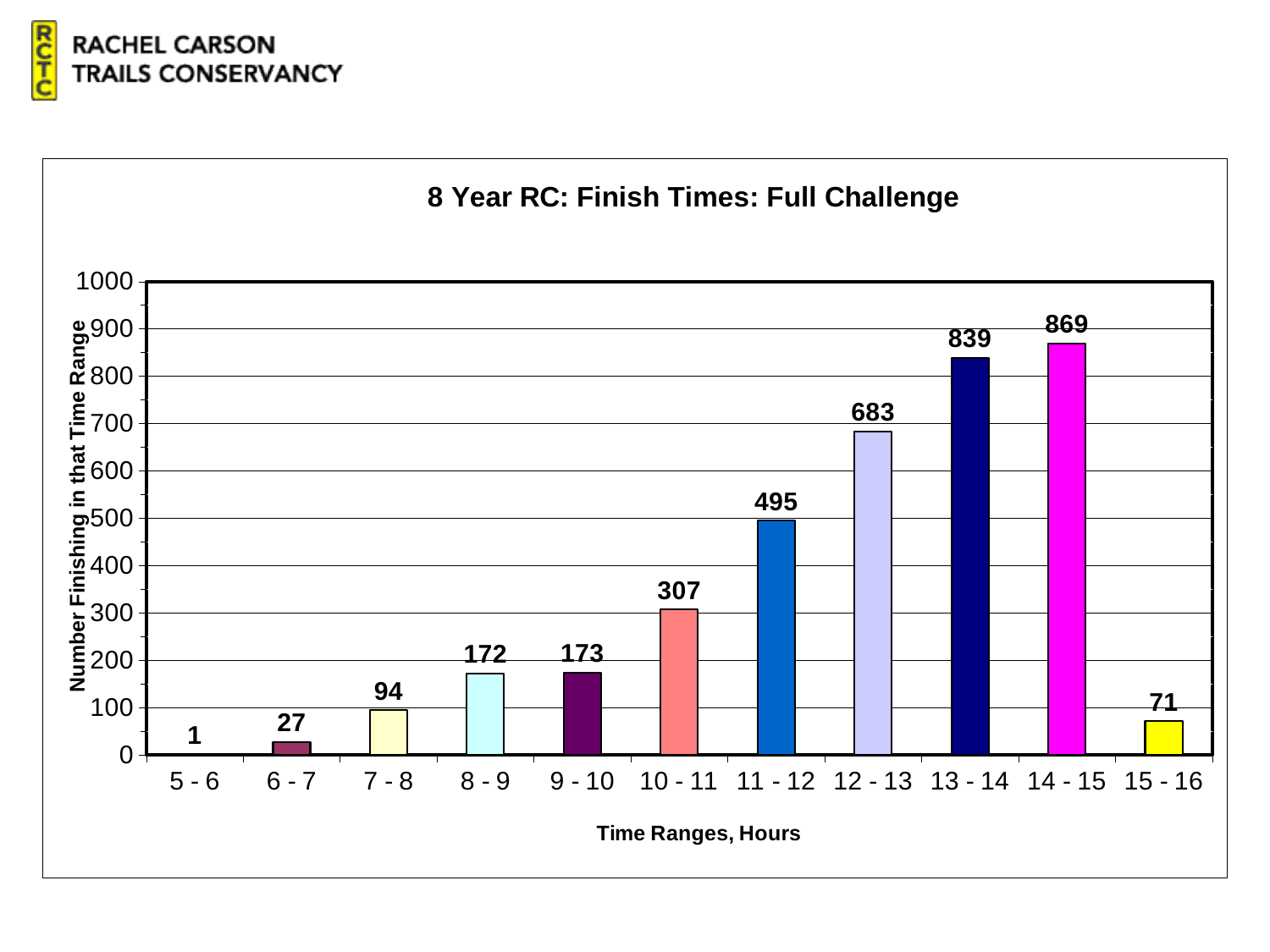
How many time range categories are shown on the x axis? 11 Which has more finishers: the 11 - 12 range or the 10 - 11 range? 11 - 12 Which time range has the lowest number of finishers? 5 - 6 How many finishers are in the 12 - 13 hour time range? 683 How many finishers are in the 7 - 8 hour time range? 94 Do the values rise or fall from the 5 - 6 range through the 14 - 15 range? rise Which time range has the highest number of finishers? 14 - 15 What is the difference between the number of finishers in the 14 - 15 range and the 13 - 14 range? 30 What is the title of the chart? 8 Year RC: Finish Times: Full Challenge What type of chart is shown on the slide? bar chart What is the label of the y axis? Number Finishing in that Time Range What is the difference between the number of finishers in the 9 - 10 range and the 8 - 9 range? 1